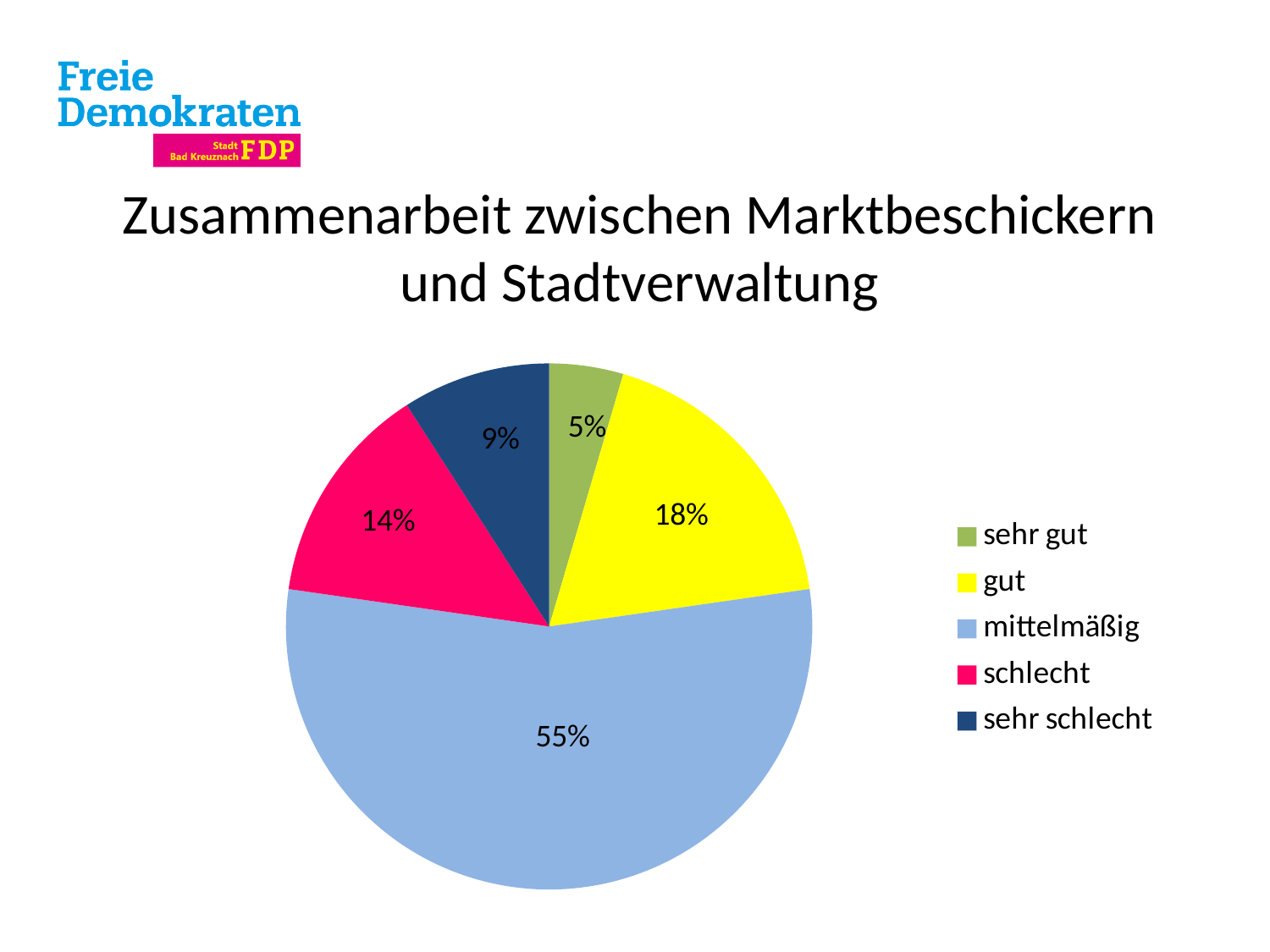
What share of the pie does "gut" represent? 18% What share of the pie does "mittelmäßig" represent? 55% What share of the pie does "schlecht" represent? 14% What is the difference in percentage points between "gut" and "schlecht"? 4 What kind of chart is shown on the slide? pie chart What is the title of the chart? Zusammenarbeit zwischen Marktbeschickern und Stadtverwaltung Which is larger, the share for "schlecht" or the share for "sehr schlecht"? schlecht Which category has the largest slice of the pie? mittelmäßig Which category has the smallest slice of the pie? sehr gut How many categories does the pie chart show? 5